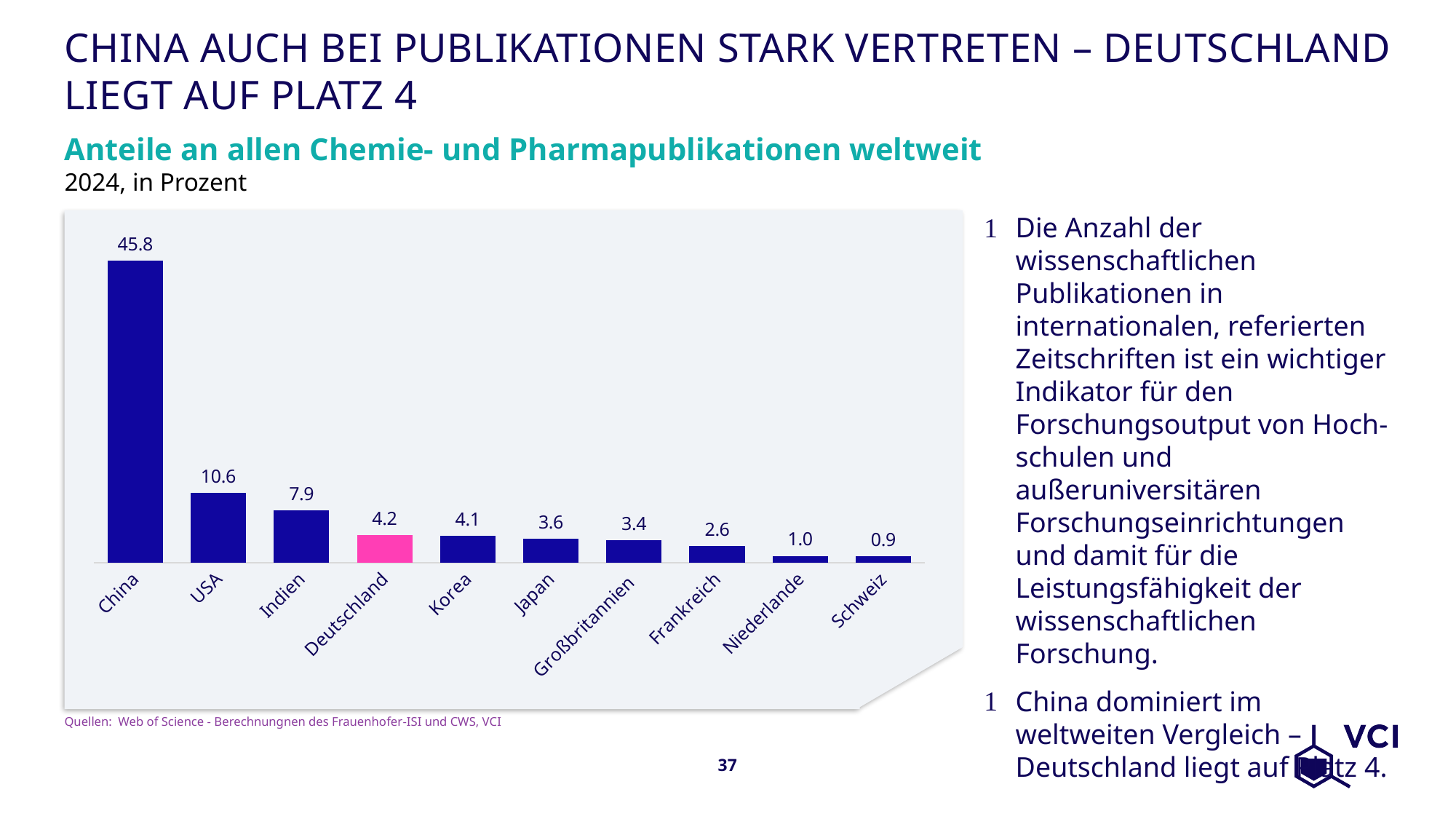
What kind of chart is shown on the slide? Bar chart What is the difference between the values for Indien and Deutschland? 3.7 Which country's bar is highlighted in pink? Deutschland What is the value for China? 45.8 How many countries are shown in the chart? 10 What is the value for Großbritannien? 3.4 Which country has the highest share? China Which country has the lowest share? Schweiz Which is larger, the value for Japan or the value for Frankreich? Japan What is the difference between the values for China and USA? 35.2 What is the value for Deutschland? 4.2 Do the values rise or fall from left to right along the x axis? Fall